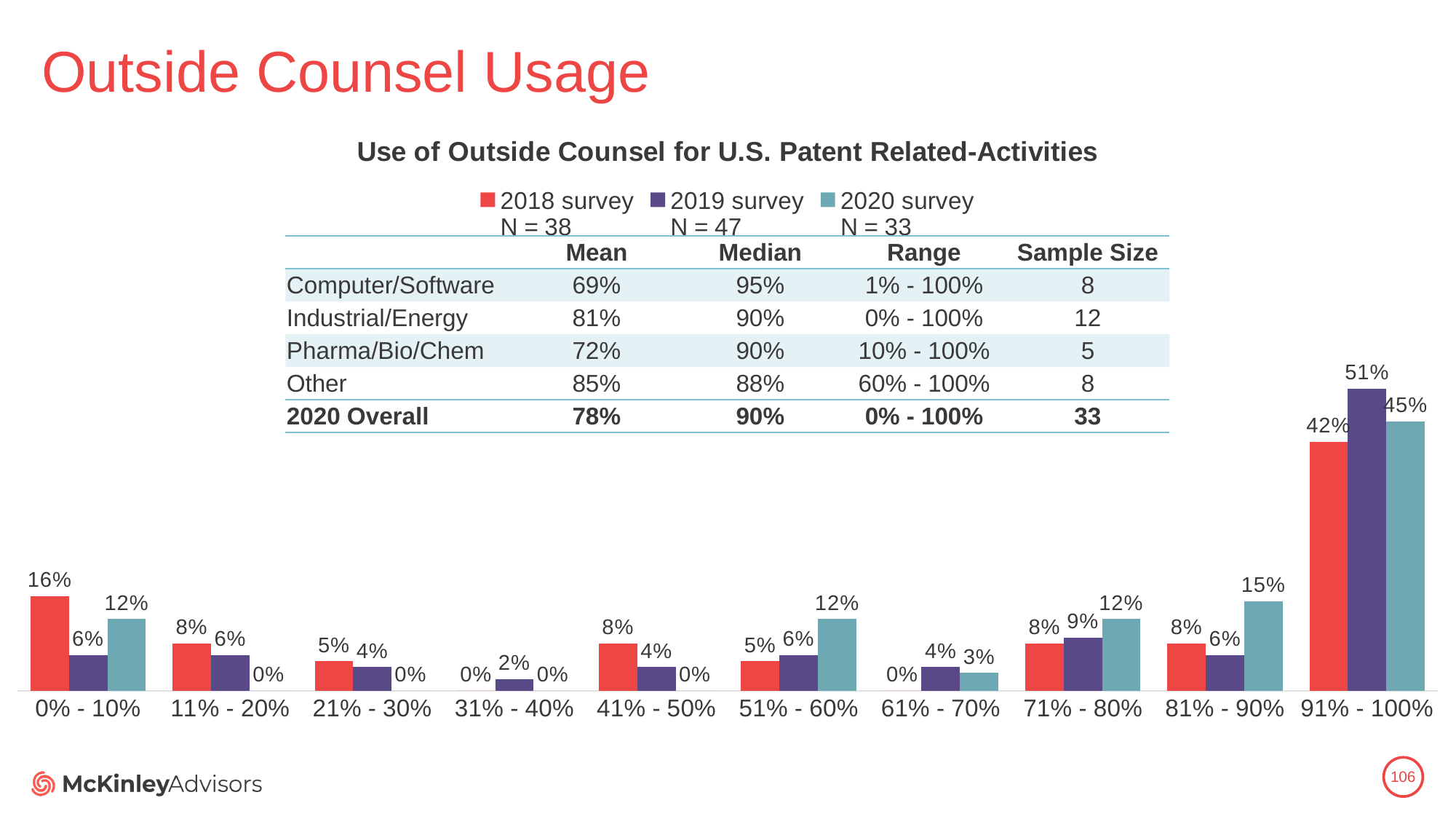
What kind of chart is shown? Bar chart How many series does the legend list? 3 What is the 2018 survey value for the 0% - 10% category? 16% In the 0% - 10% category, which is larger: the 2018 survey value or the 2020 survey value? 2018 survey Which category has the lowest 2018 survey value? 31% - 40% and 61% - 70% (both 0%) What is the difference between the 2019 survey and 2018 survey values in the 91% - 100% category? 9% Which category has the highest 2020 survey value? 91% - 100% How many categories are shown on the x axis? 10 What is the sample size (N) for the 2019 survey shown in the legend? 47 What is the title of the chart? Use of Outside Counsel for U.S. Patent Related-Activities What is the 2019 survey value for the 91% - 100% category? 51% What is the 2020 survey value for the 81% - 90% category? 15%